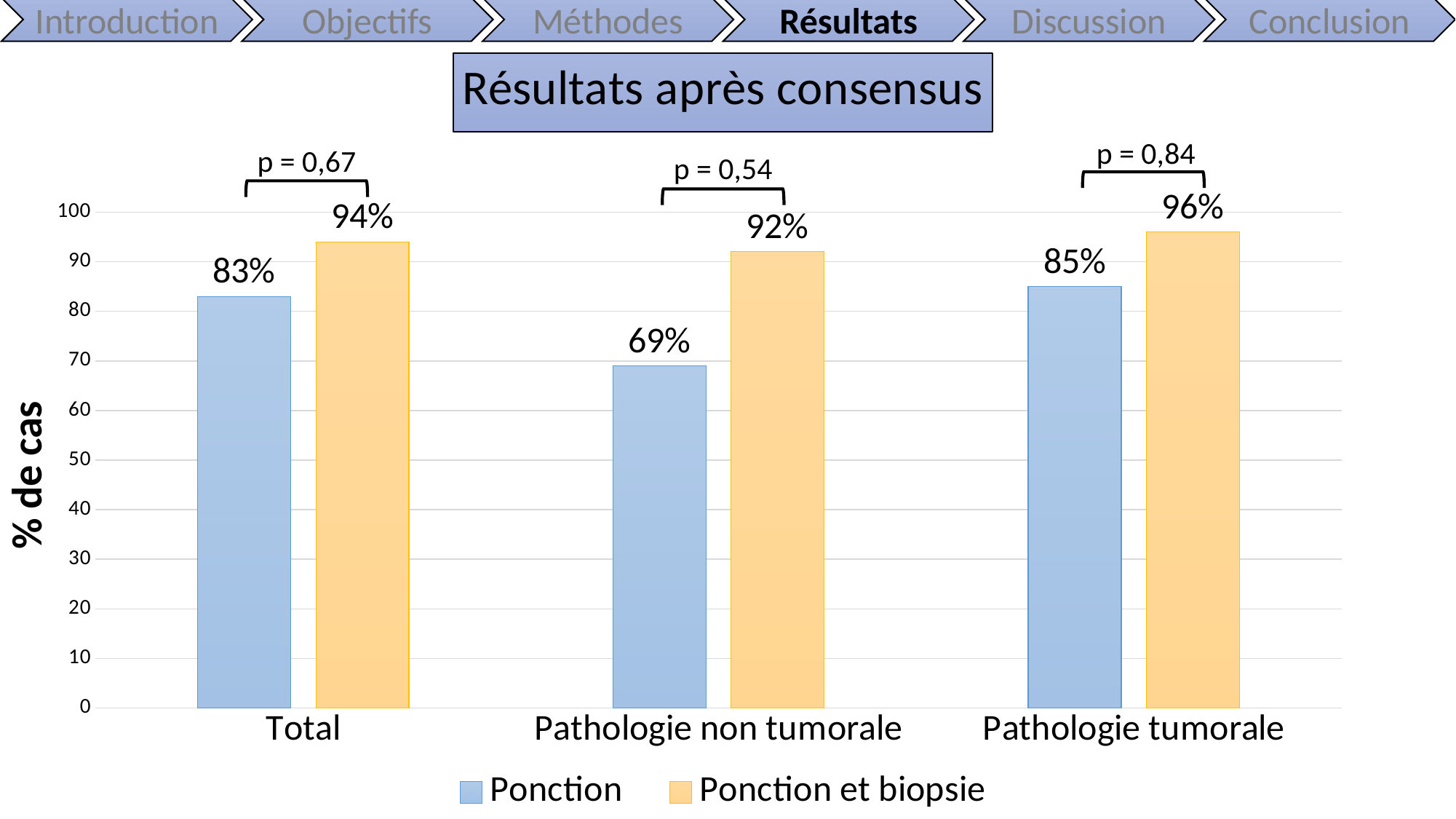
What is the value for Ponction in the Total category? 83% What is the value for Ponction in the Pathologie tumorale category? 85% Is the value for Ponction in the Pathologie non tumorale category greater or less than 80? less What kind of chart is shown on the slide? bar chart How many series does the legend list? 2 Which category has the highest value for Ponction et biopsie? Pathologie tumorale What is the value for Ponction et biopsie in the Pathologie non tumorale category? 92% Which is larger in the Total category: Ponction or Ponction et biopsie? Ponction et biopsie Which category has the lowest value for Ponction? Pathologie non tumorale What is the p-value shown above the Pathologie tumorale category? p = 0,84 How many categories are shown on the x axis? 3 What is the difference between Ponction et biopsie and Ponction in the Pathologie non tumorale category? 23%